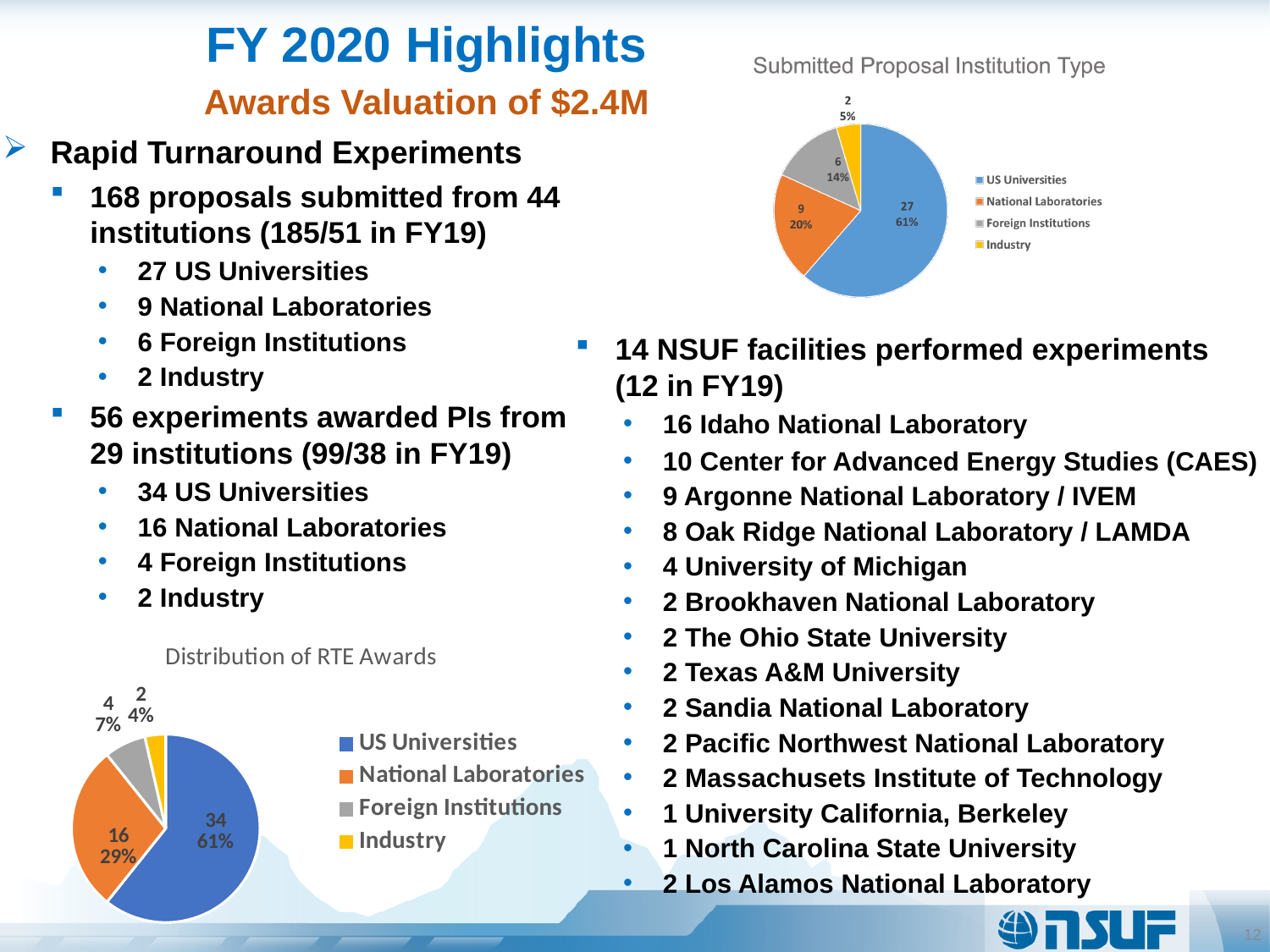
In the 'Submitted Proposal Institution Type' chart, how many categories does the legend list? 4 In the 'Distribution of RTE Awards' chart, which category has the largest slice? US Universities In the 'Distribution of RTE Awards' chart, which is larger, Foreign Institutions or Industry? Foreign Institutions In the 'Submitted Proposal Institution Type' chart, what share of the pie is National Laboratories? 20% In the 'Submitted Proposal Institution Type' chart, which institution type has the smallest slice? Industry In the 'Distribution of RTE Awards' chart, what colour is the Industry slice? Yellow In the 'Distribution of RTE Awards' chart, what share of the pie is US Universities? 61% In the 'Submitted Proposal Institution Type' chart, what is the difference between the US Universities count and the Foreign Institutions count? 21 In the 'Submitted Proposal Institution Type' chart, how many proposals came from US Universities? 27 In the 'Distribution of RTE Awards' chart, how many awards went to National Laboratories? 16 In the 'Distribution of RTE Awards' chart, what is the total of all slices? 56 In the 'Submitted Proposal Institution Type' chart, what kind of chart is shown? Pie chart